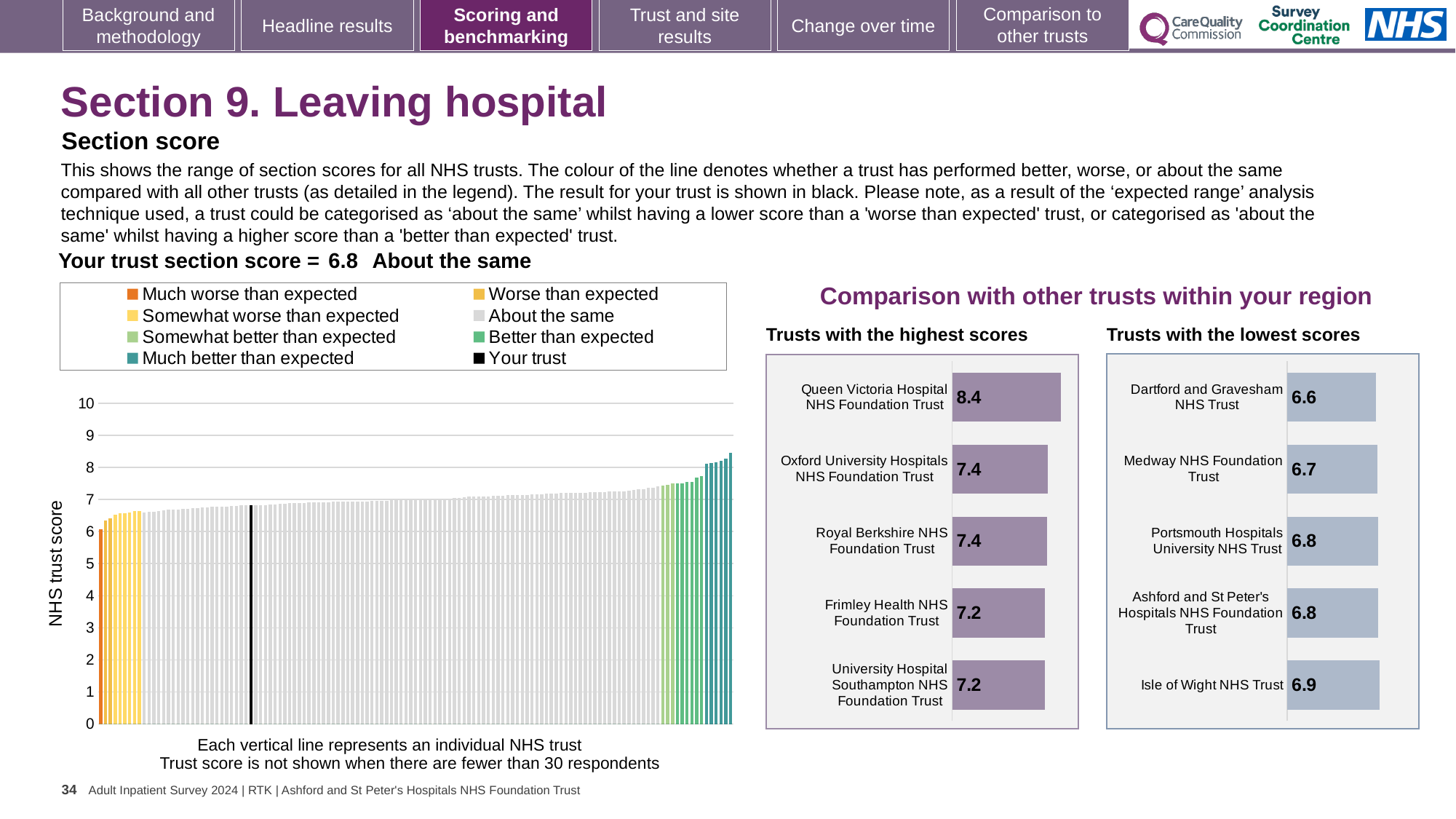
In the 'Trusts with the lowest scores' chart, what is the difference between the scores of Isle of Wight NHS Trust and Dartford and Gravesham NHS Trust? 0.3 In the 'Trusts with the highest scores' chart, what is the difference between the scores of Queen Victoria Hospital NHS Foundation Trust and Frimley Health NHS Foundation Trust? 1.2 In the 'Trusts with the lowest scores' chart, which has the higher score: Medway NHS Foundation Trust or Isle of Wight NHS Trust? Isle of Wight NHS Trust What kind of chart is the main chart of NHS trust scores on the left? Bar chart In the main chart of NHS trust scores on the left, do the trust scores rise or fall from left to right? Rise In the 'Trusts with the highest scores' chart, which trust has the highest score? Queen Victoria Hospital NHS Foundation Trust In the 'Trusts with the highest scores' chart, what is the score for Queen Victoria Hospital NHS Foundation Trust? 8.4 In the 'Trusts with the lowest scores' chart, what is the score for Dartford and Gravesham NHS Trust? 6.6 In the 'Trusts with the lowest scores' chart, which trust has the lowest score? Dartford and Gravesham NHS Trust In the 'Trusts with the highest scores' chart, how many trusts are shown? 5 In the main chart of NHS trust scores on the left, how many entries does the legend list? 8 In the main chart of NHS trust scores on the left, what is the section score for your trust? 6.8